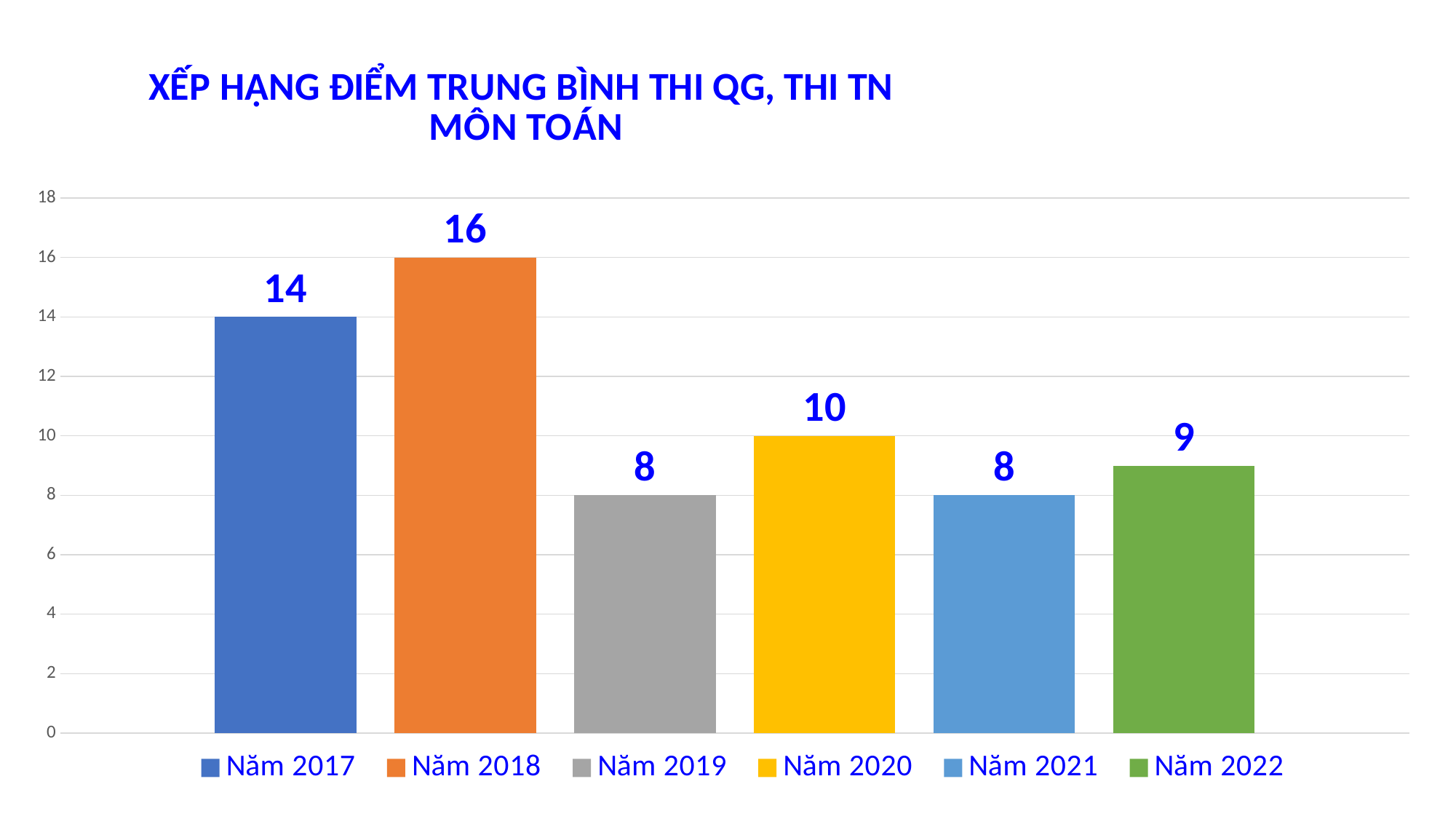
How many bars are shown in the chart? 6 What is the difference between the values for Năm 2018 and Năm 2017? 2 What is the value for Năm 2022? 9 What is the value for Năm 2017? 14 Which is larger, the value for Năm 2020 or the value for Năm 2022? Năm 2020 What is the value for Năm 2020? 10 What colour is the bar for Năm 2020? Yellow What is the difference between the values for Năm 2020 and Năm 2019? 2 Is the value for Năm 2018 greater or less than 12? greater What kind of chart is shown on the slide? Bar chart How many entries does the legend list? 6 Which year has the highest value? Năm 2018